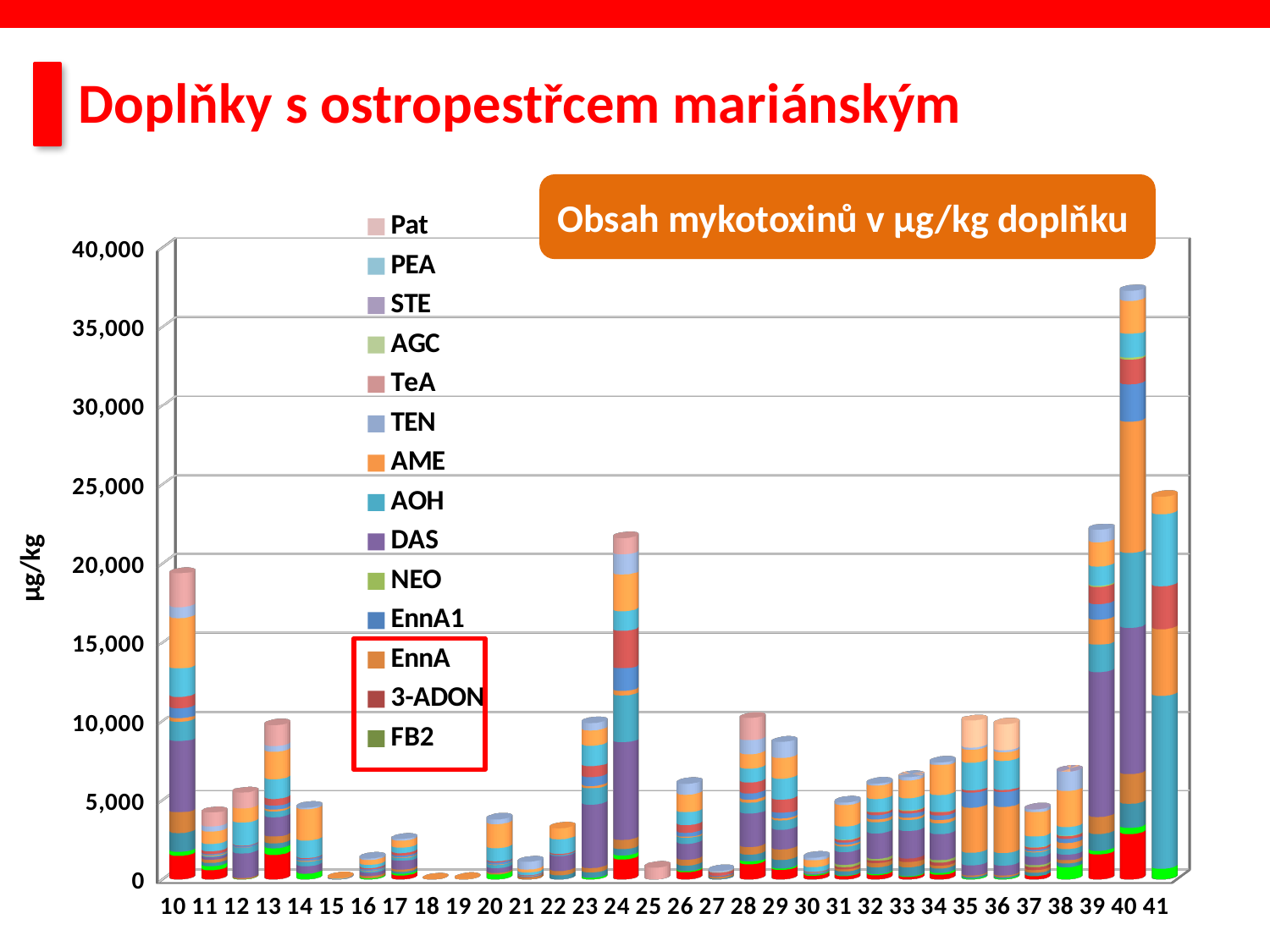
Which category has the tallest bar in the chart? 40 Which bar is taller, category 28 or category 29? 28 How many categories are shown along the x axis of the chart? 32 Is the total value for category 24 greater or less than 20,000? greater Is the total value for category 10 greater or less than 20,000? less Is the total value for category 41 greater or less than 25,000? less Which bar is taller, category 40 or category 41? 40 What is the title shown in the orange box above the chart? Obsah mykotoxinů v µg/kg doplňku What kind of chart is shown on the slide? stacked bar chart What is the label on the vertical axis of the chart? µg/kg